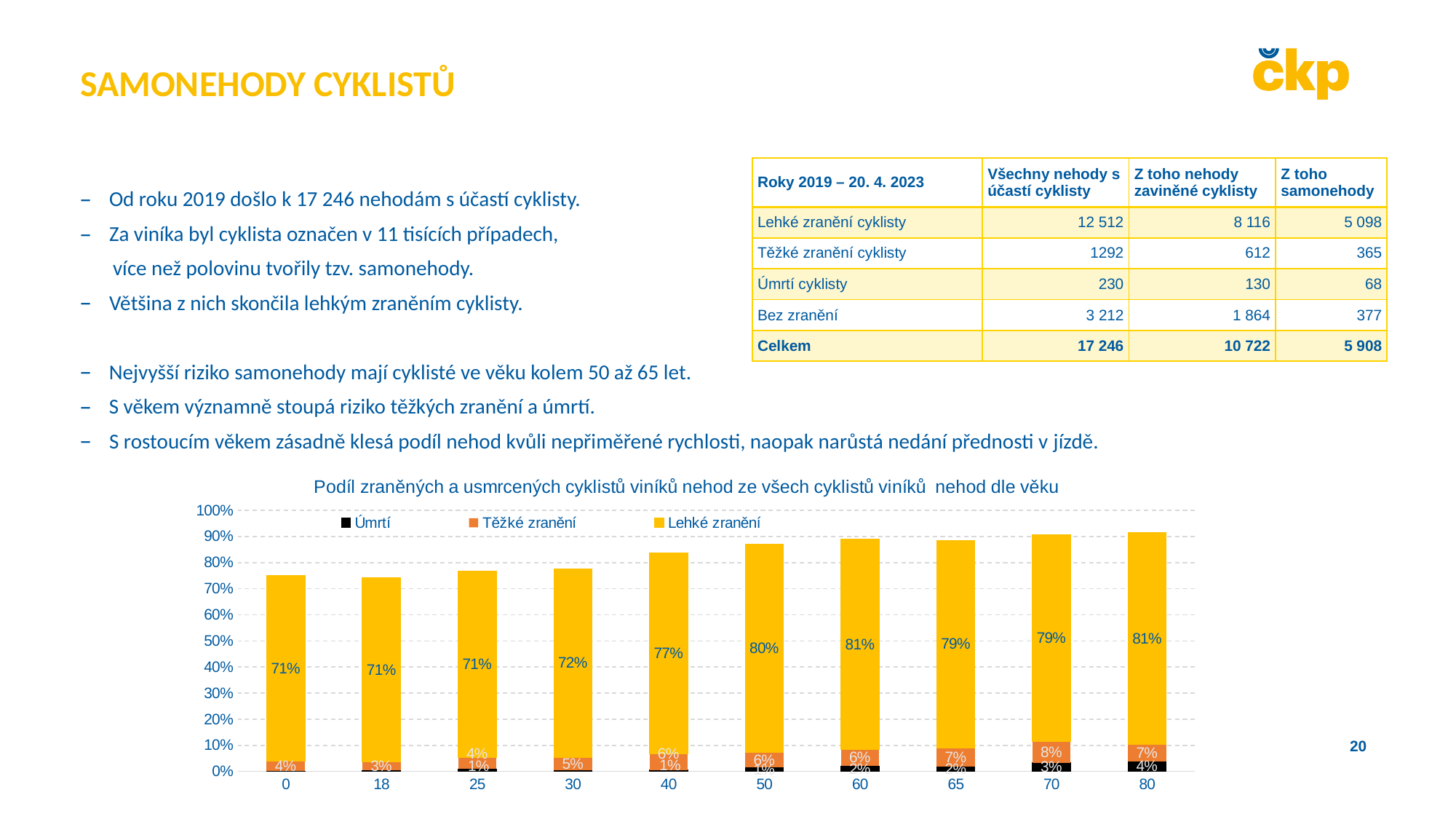
What is the value of Lehké zranění for age category 50? 80% What kind of chart is shown on the slide? Stacked bar chart Which is larger: the Lehké zranění value for age category 50 or for age category 30? 50 Is the total height of the stacked bar for age category 40 greater or less than 90%? less Which colour represents Lehké zranění in the chart? Yellow What is the value of Úmrtí for age category 80? 4% How many age categories are shown on the x axis of the chart? 10 What is the value of Těžké zranění for age category 70? 8% Which age category has the highest value for Těžké zranění? 70 Which age category has the highest value for Úmrtí? 80 What is the difference between the Lehké zranění value for age category 80 and for age category 0? 10 percentage points How many series does the chart legend list? 3